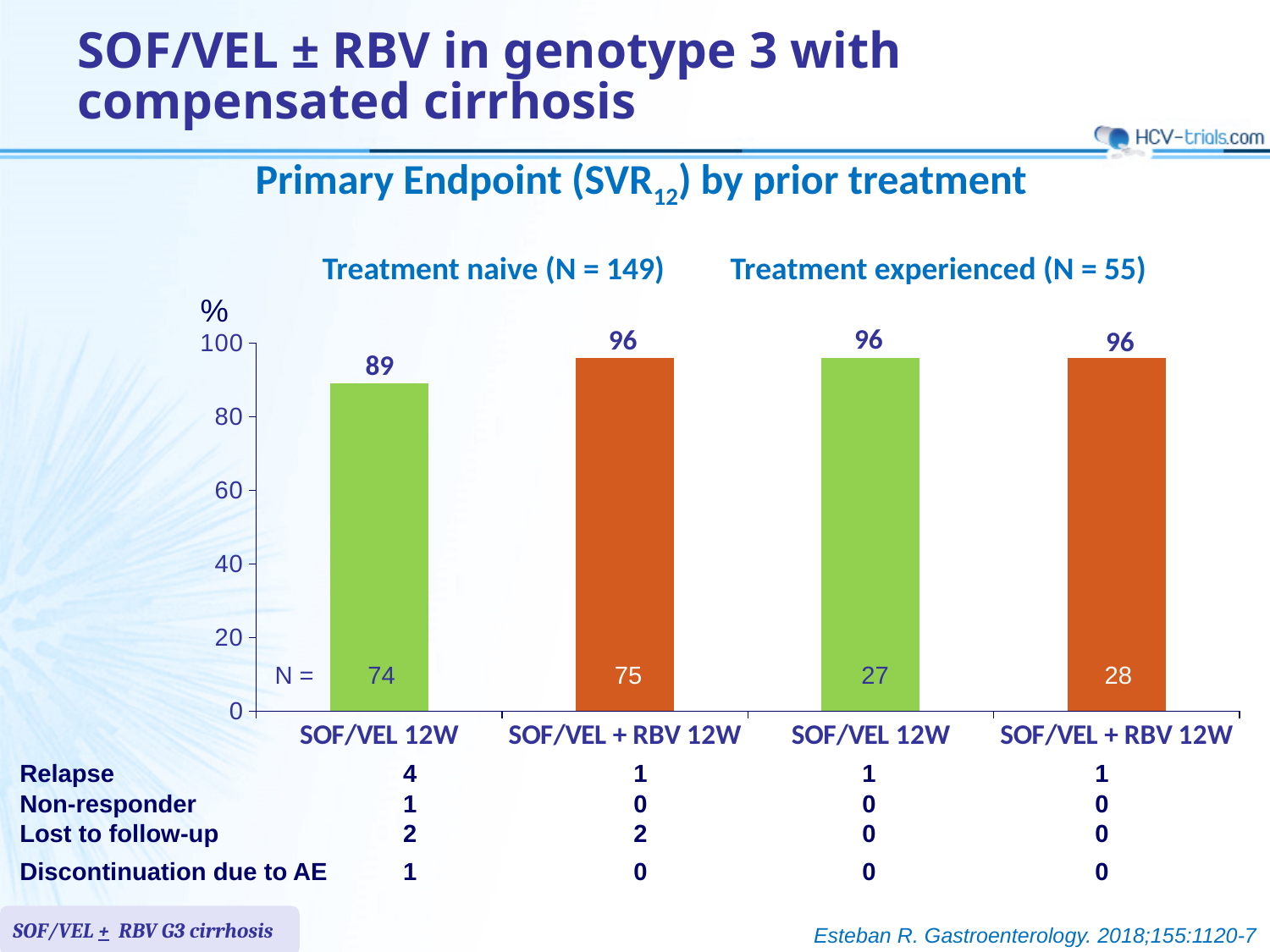
In the treatment naive group, which has the higher SVR12 rate: SOF/VEL 12W or SOF/VEL + RBV 12W? SOF/VEL + RBV 12W What type of chart is shown on the slide? bar chart How many bars are shown in the chart? 4 What is the difference in SVR12 rate between SOF/VEL + RBV 12W and SOF/VEL 12W in the treatment naive group? 7 What is the SVR12 rate for SOF/VEL + RBV 12W in the treatment naive group? 96 What colour are the SOF/VEL + RBV 12W bars? orange Is the SVR12 rate for SOF/VEL 12W in the treatment naive group greater or less than 80? greater Which bar has the lowest SVR12 rate? SOF/VEL 12W (treatment naive) What is the total N for the treatment naive group shown above the chart? 149 How many patients (N) are in the SOF/VEL + RBV 12W arm of the treatment experienced group? 28 What is the SVR12 rate for SOF/VEL 12W in the treatment naive group? 89 What is the SVR12 rate for SOF/VEL 12W in the treatment experienced group? 96